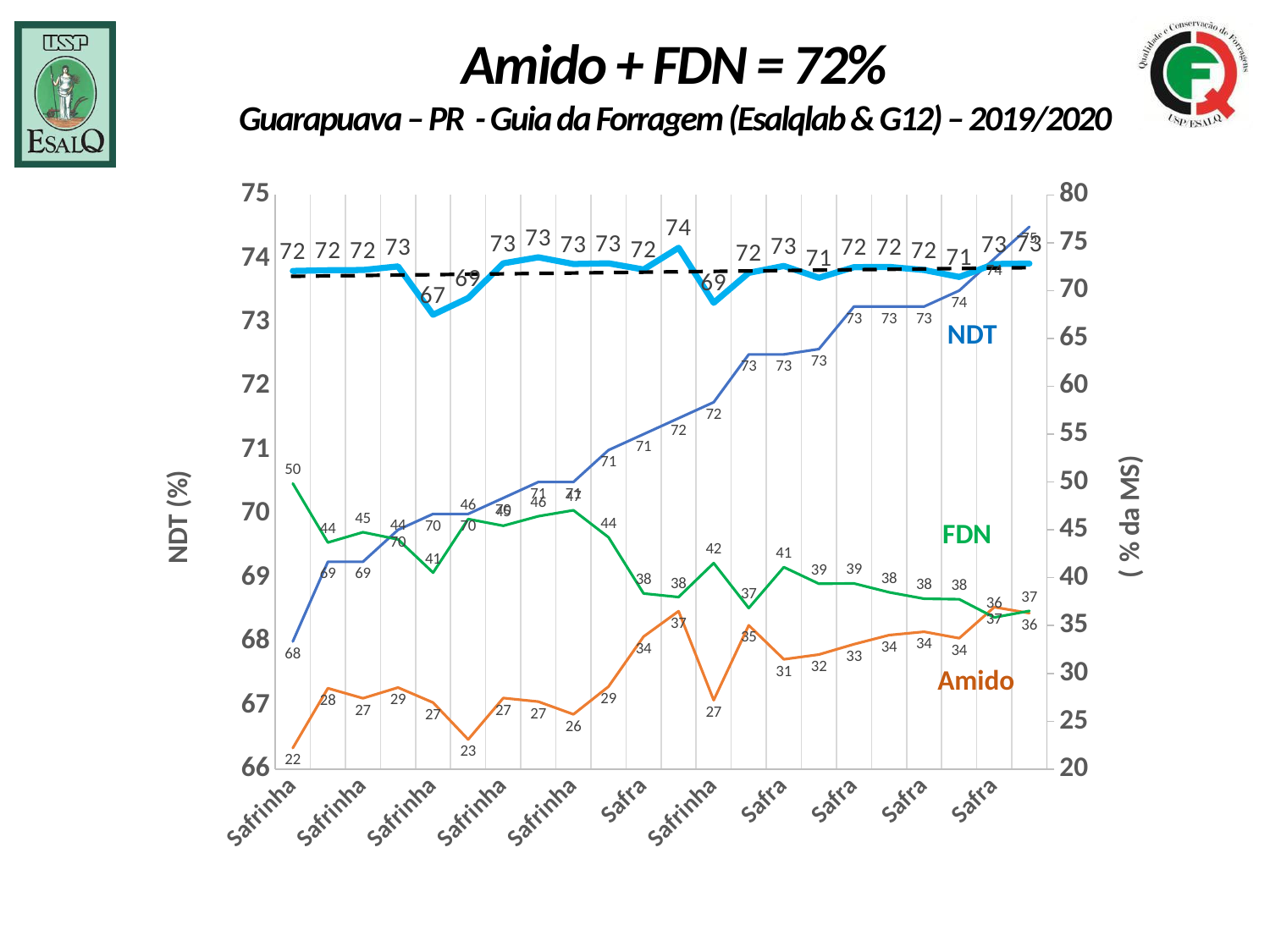
What is the NDT value at the first point on the left of the chart? 68 What is the highest value of the Amido series? 37 Does the NDT series rise or fall from left to right across the chart? rises At the first point on the left, which is larger, FDN or Amido? FDN What is the lowest value of the FDN series? 36 Does the FDN series rise or fall from left to right across the chart? falls What is the title of the chart? Amido + FDN = 72% Which series is drawn in green? FDN What is the lowest value of the Amido series? 22 What is the difference between the FDN value and the Amido value at the first point on the left? 28 What kind of chart is shown on the slide? line chart What is the highest value of the FDN series? 50